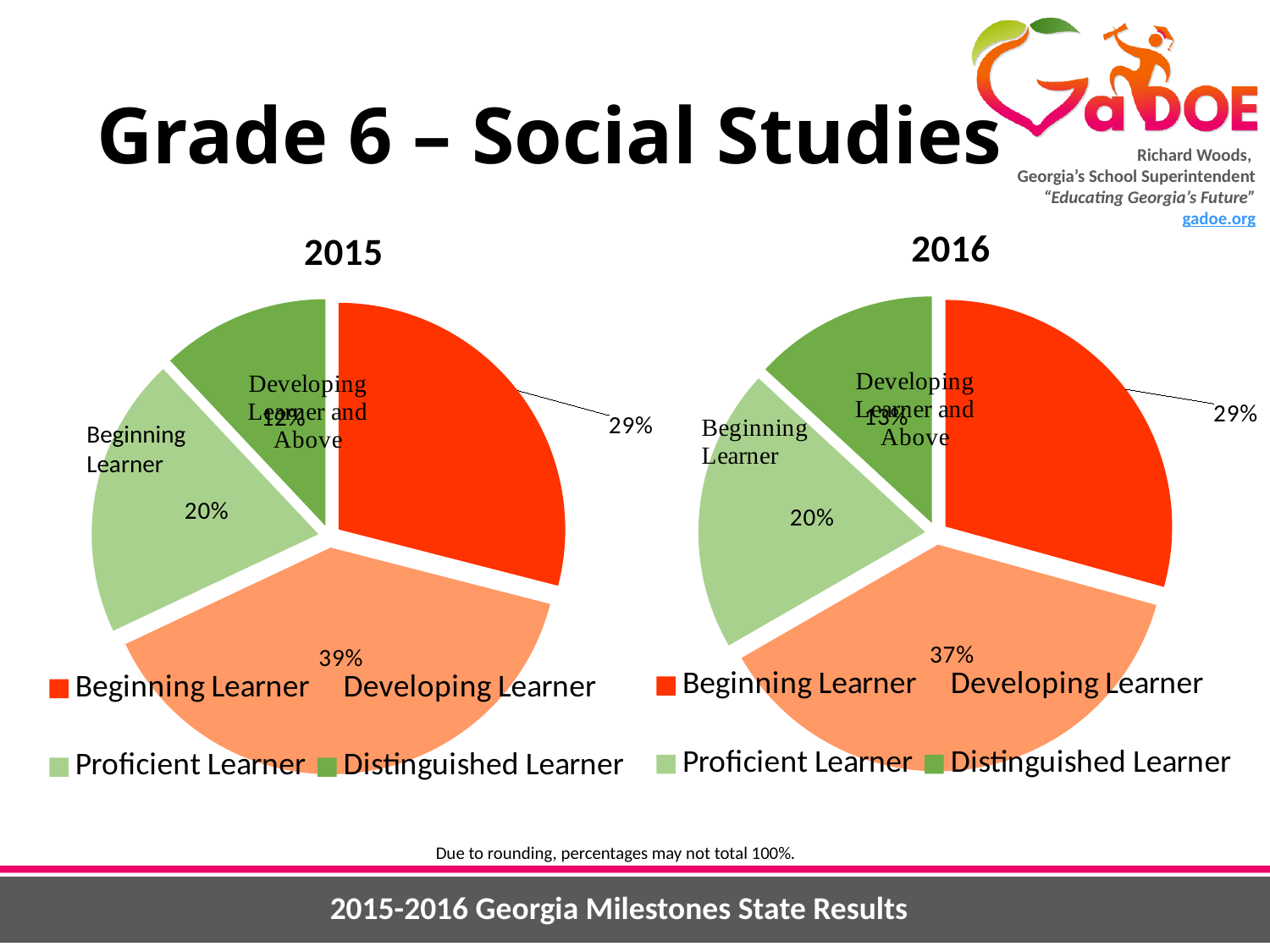
What type of chart is used for the 2015 data? Pie chart In the 2015 chart, what percentage is shown for Developing Learner? 39% In the 2016 chart, which category has the smallest slice? Distinguished Learner In the 2016 chart, what percentage is shown for Distinguished Learner? 13% What is the difference between the Developing Learner percentage in the 2015 chart and in the 2016 chart? 2% In the 2015 chart, what percentage is shown for Beginning Learner? 29% How many slices does the 2016 pie chart have? 4 In the 2016 chart, what percentage is shown for Proficient Learner? 20% In the 2015 chart, which is larger: the Beginning Learner slice or the Proficient Learner slice? Beginning Learner In the 2016 chart's legend, which category is shown in red? Beginning Learner In the 2016 chart, what percentage is shown for Developing Learner? 37% In the 2015 chart, which category has the largest slice? Developing Learner